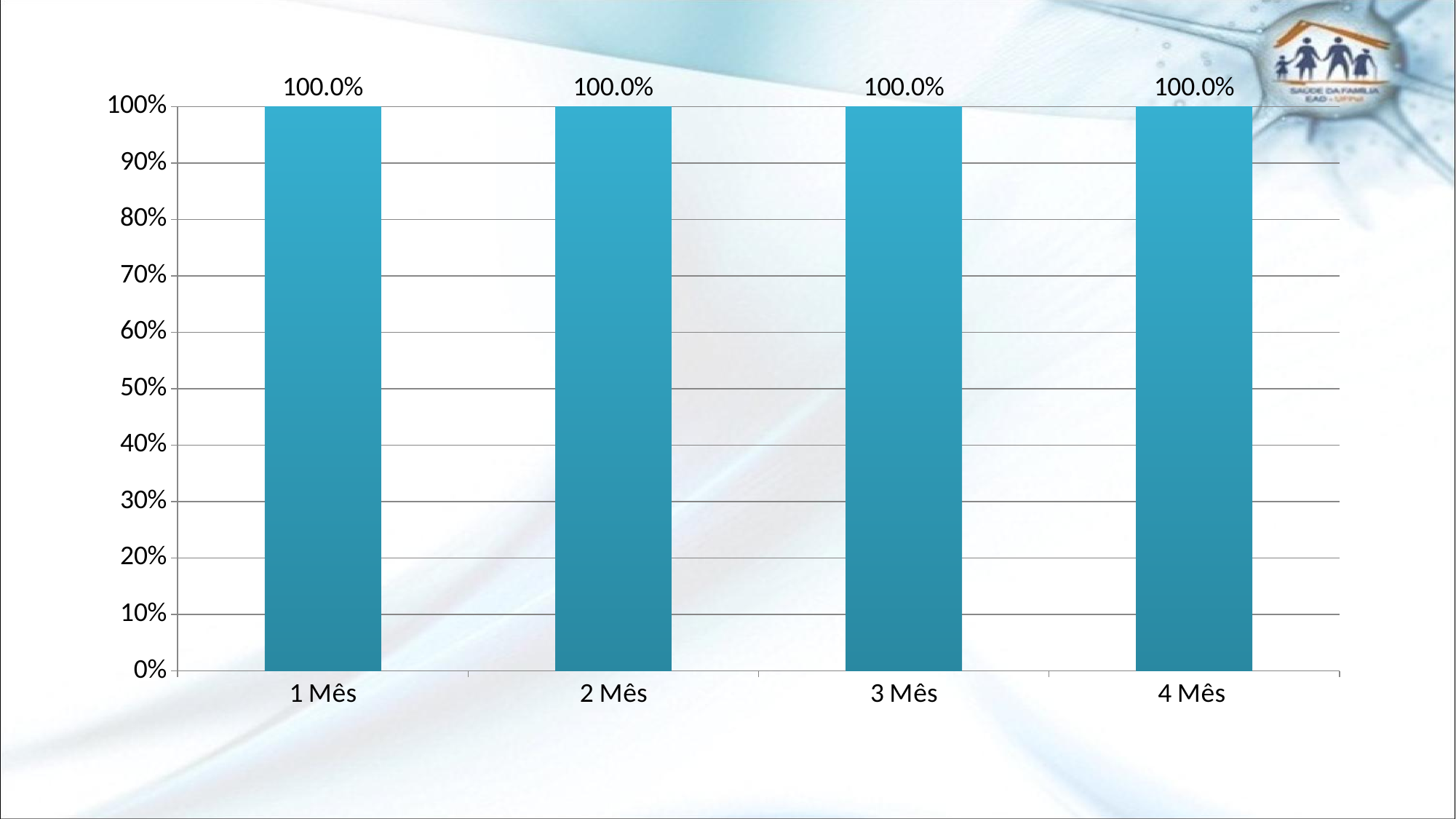
What is the difference between the values for 1 Mês and 4 Mês? 0.0% Do the values rise, fall, or stay the same from 1 Mês to 4 Mês? stay the same What is the highest value shown on the y axis? 100% What is the value for 4 Mês? 100.0% What kind of chart is shown on the slide? bar chart What is the value for 3 Mês? 100.0% How many categories are shown on the x axis? 4 What is the label of the first category on the x axis? 1 Mês What is the value for 2 Mês? 100.0% What is the value for 1 Mês? 100.0% Is the value for 2 Mês greater or less than 50%? greater